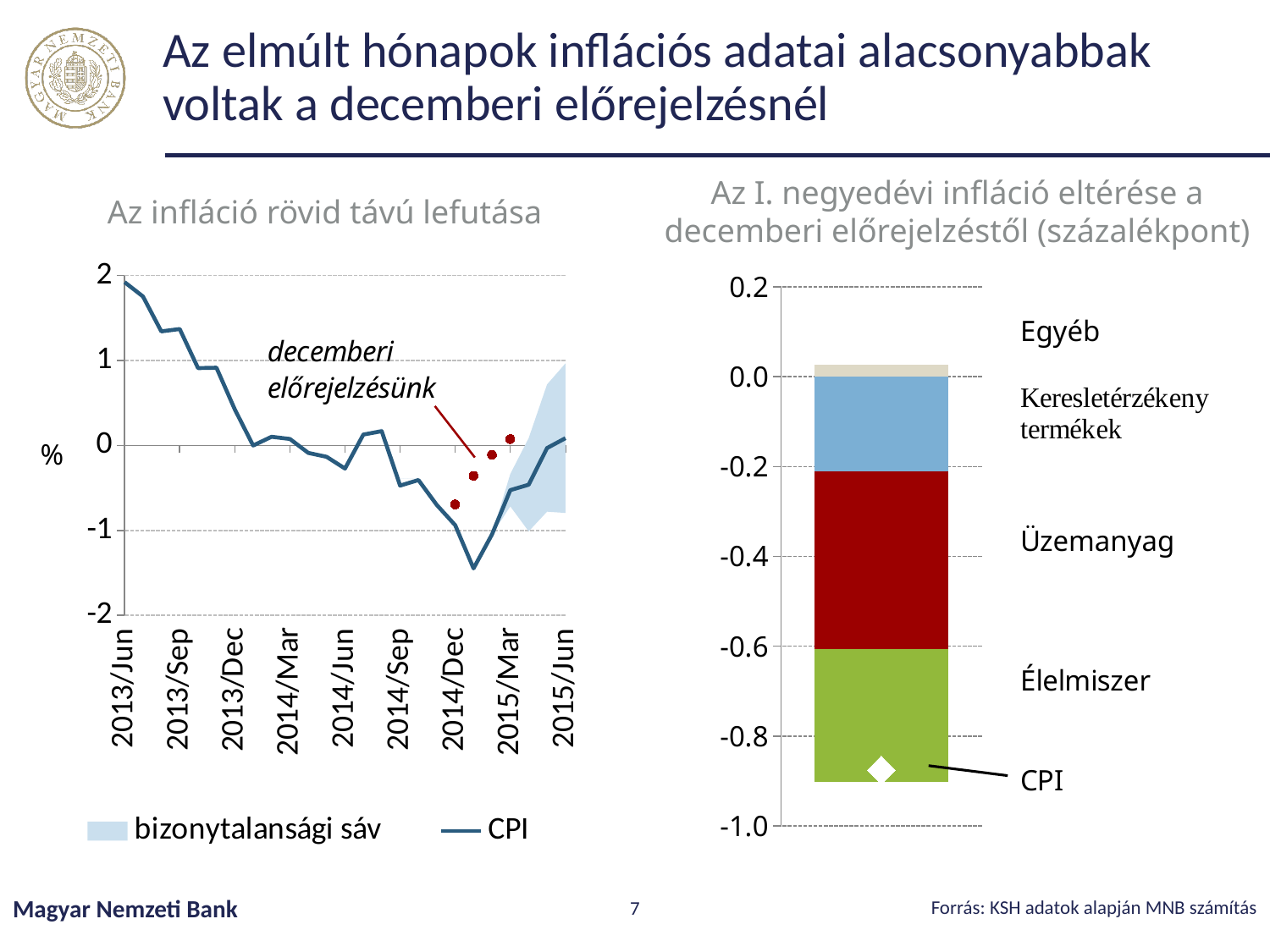
In the left chart, does the CPI line overall rise or fall from 2013/Jun to 2015/Jan? fall What unit is shown on the y axis of the left chart? % In the right chart, how many components are stacked in the bar? 4 In the left chart, is the CPI value at 2014/Dec greater or less than 0? less What kind of chart is the right chart, 'Az I. negyedévi infláció eltérése a decemberi előrejelzéstől'? stacked bar chart What are the two legend entries of the left chart? bizonytalansági sáv, CPI What kind of chart is the left chart, 'Az infláció rövid távú lefutása'? line chart In the right chart, which component has the largest negative contribution? Üzemanyag In the right chart, is the CPI marker greater or less than -0.8? less How many entries does the legend of the left chart list? 2 In the left chart, at which x-axis label is the CPI line at its highest? 2013/Jun In the left chart, is the CPI value at 2013/Jun greater or less than 1? greater